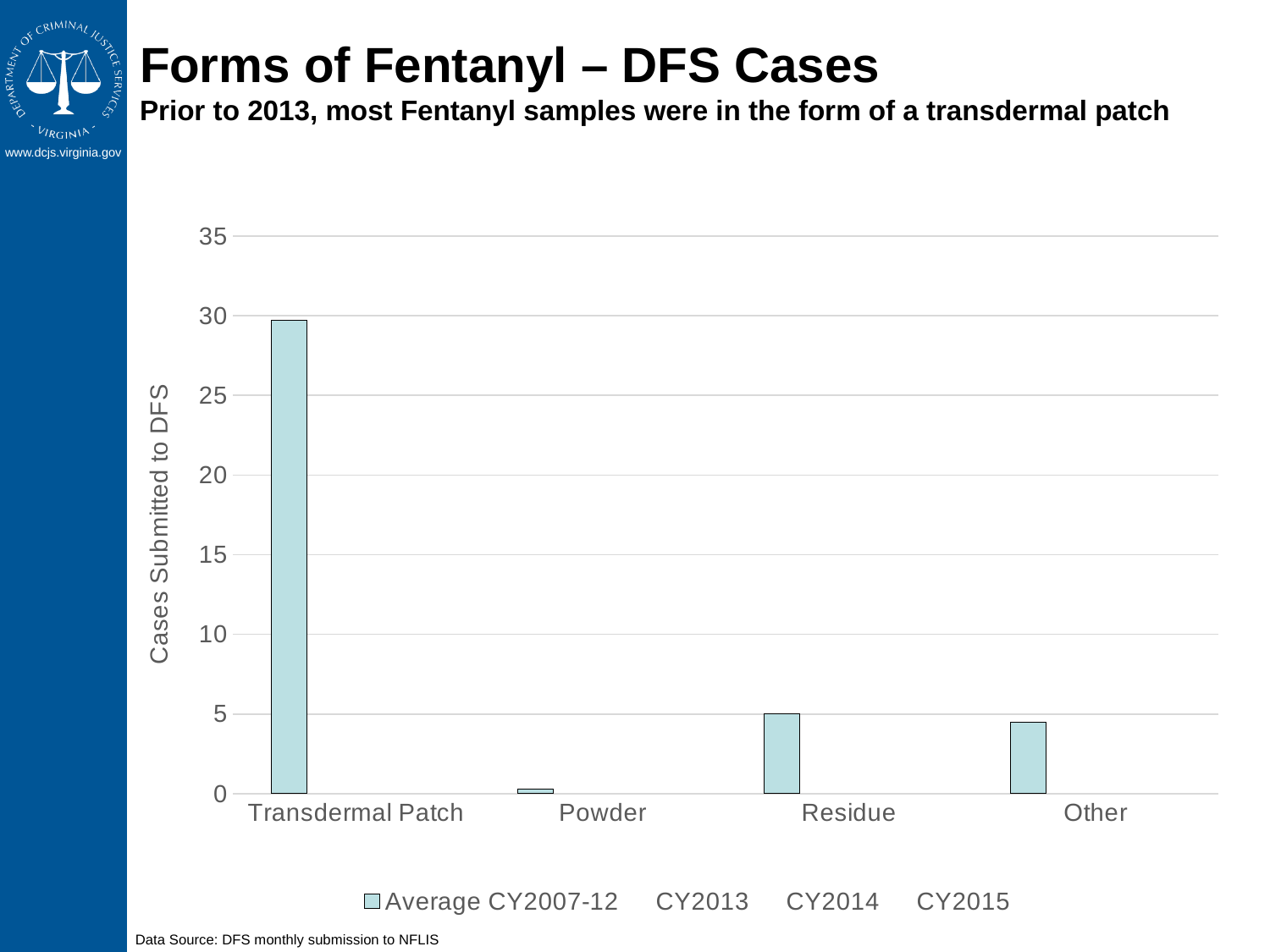
Is the value for Other greater or less than 5? less How many categories are shown on the x axis of the chart? 4 Which category has the highest number of cases submitted to DFS? Transdermal Patch Is the value for Transdermal Patch greater or less than 25? greater What kind of chart is shown on the slide? bar chart Which has more cases submitted to DFS, Transdermal Patch or Residue? Transdermal Patch What is the title of the y axis of the chart? Cases Submitted to DFS Which category has the lowest number of cases submitted to DFS? Powder Is the value for Transdermal Patch greater or less than 35? less What is the first entry listed in the chart's legend? Average CY2007-12 Which has more cases submitted to DFS, Residue or Other? Residue